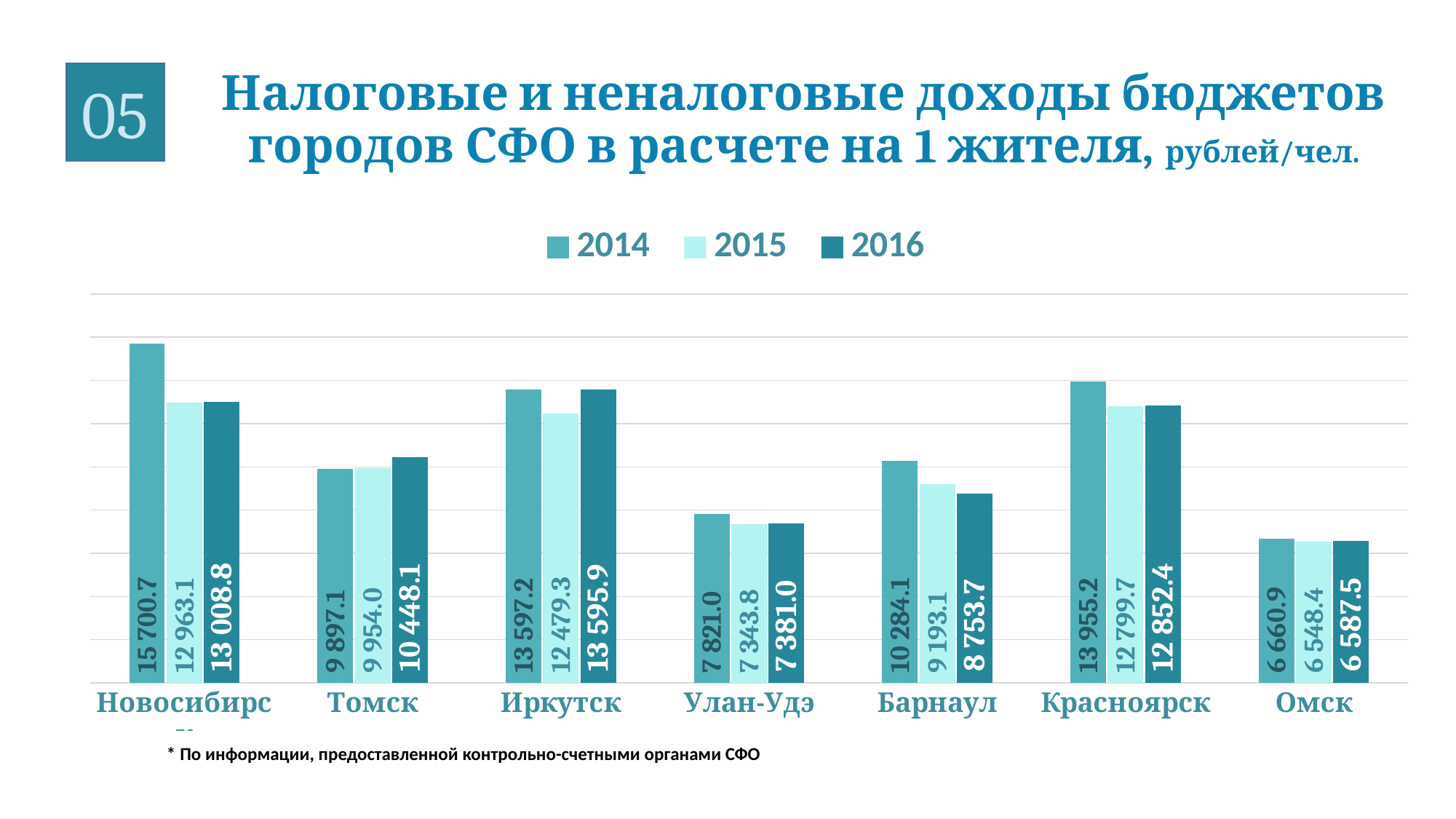
What is the difference between the 2014 and 2016 values for Барнаул? 1 530.4 What is the difference between the 2014 and 2016 values for Новосибирск? 2 691.9 How many series does the legend list? 3 What is the value for Улан-Удэ in 2015? 7 343.8 Which is larger in 2016: Иркутск or Красноярск? Иркутск How many cities are shown on the chart? 7 What is the value for Томск in 2016? 10 448.1 Do the values for Барнаул rise or fall from 2014 to 2016? Fall What is the value for Красноярск in 2014? 13 955.2 What kind of chart is shown on the slide? Bar chart Which city has the lowest value in 2016? Омск Which city has the highest value in 2014? Новосибирск